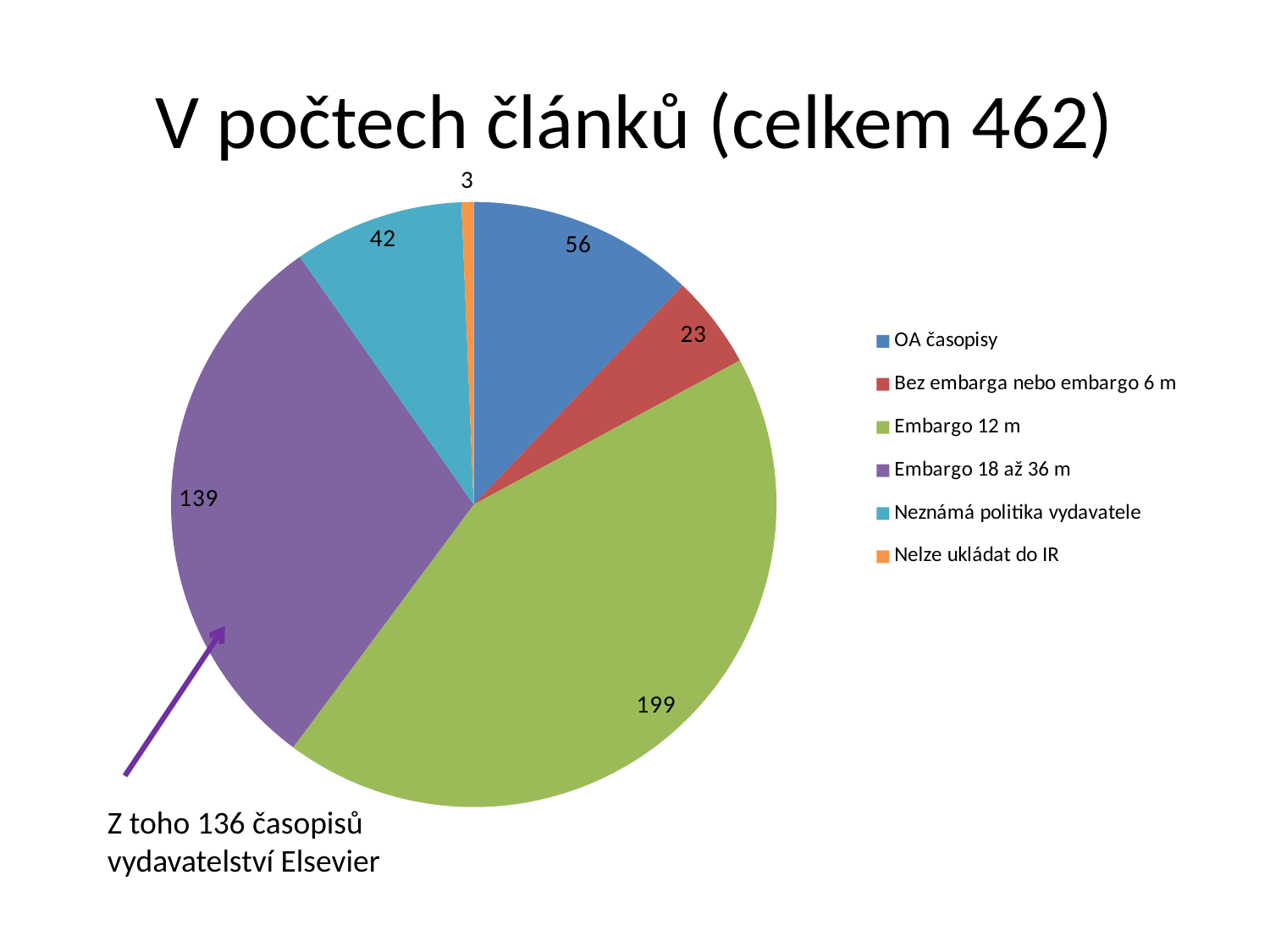
What is the total of all slices in the pie chart? 462 What is the title of the chart slide? V počtech článků (celkem 462) What is the value for Nelze ukládat do IR? 3 What is the value for OA časopisy? 56 Which category has the largest slice? Embargo 12 m What is the value for Embargo 12 m? 199 Which category has the smallest slice? Nelze ukládat do IR How many categories does the pie chart have? 6 What is the value for Neznámá politika vydavatele? 42 Which is larger, OA časopisy or Bez embarga nebo embargo 6 m? OA časopisy What is the difference between Embargo 12 m and Embargo 18 až 36 m? 60 What kind of chart is shown on the slide? pie chart